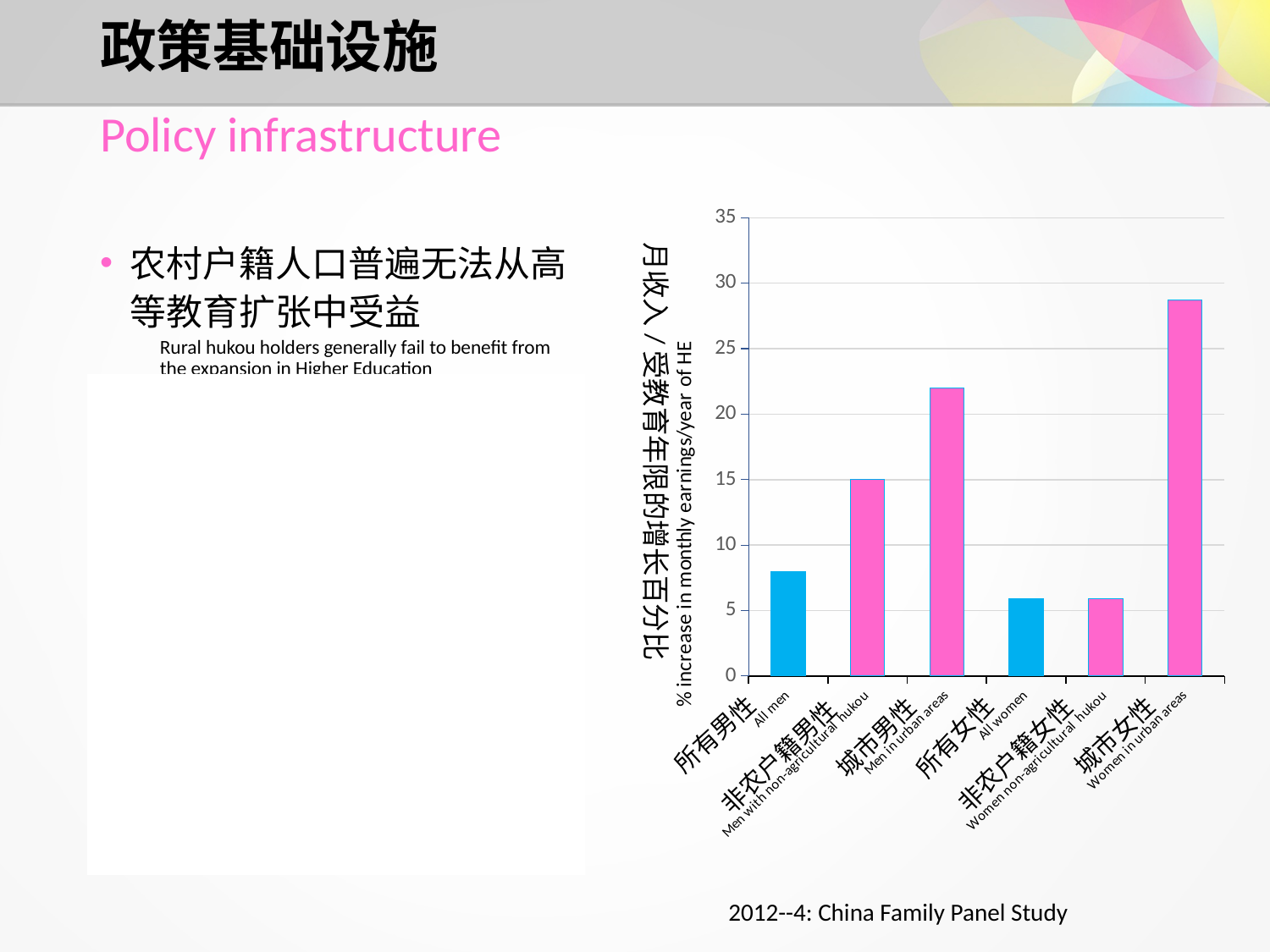
Which is larger: the value for Women in urban areas or the value for Men in urban areas? Women in urban areas What kind of chart is shown on the slide? bar chart What data source is cited below the chart? 2012--4: China Family Panel Study Is the value for All men greater or less than 10? less Is the value for Men in urban areas greater or less than 20? greater What is the English label on the vertical axis of the chart? % increase in monthly earnings/year of HE Which category has the highest value in the chart? Women in urban areas Which is larger: the value for All men or the value for All women? All men How many categories (bars) are plotted in the chart? 6 Is the value for All women greater or less than 10? less Which is larger: the value for Men in urban areas or the value for Men with non-agricultural hukou? Men in urban areas